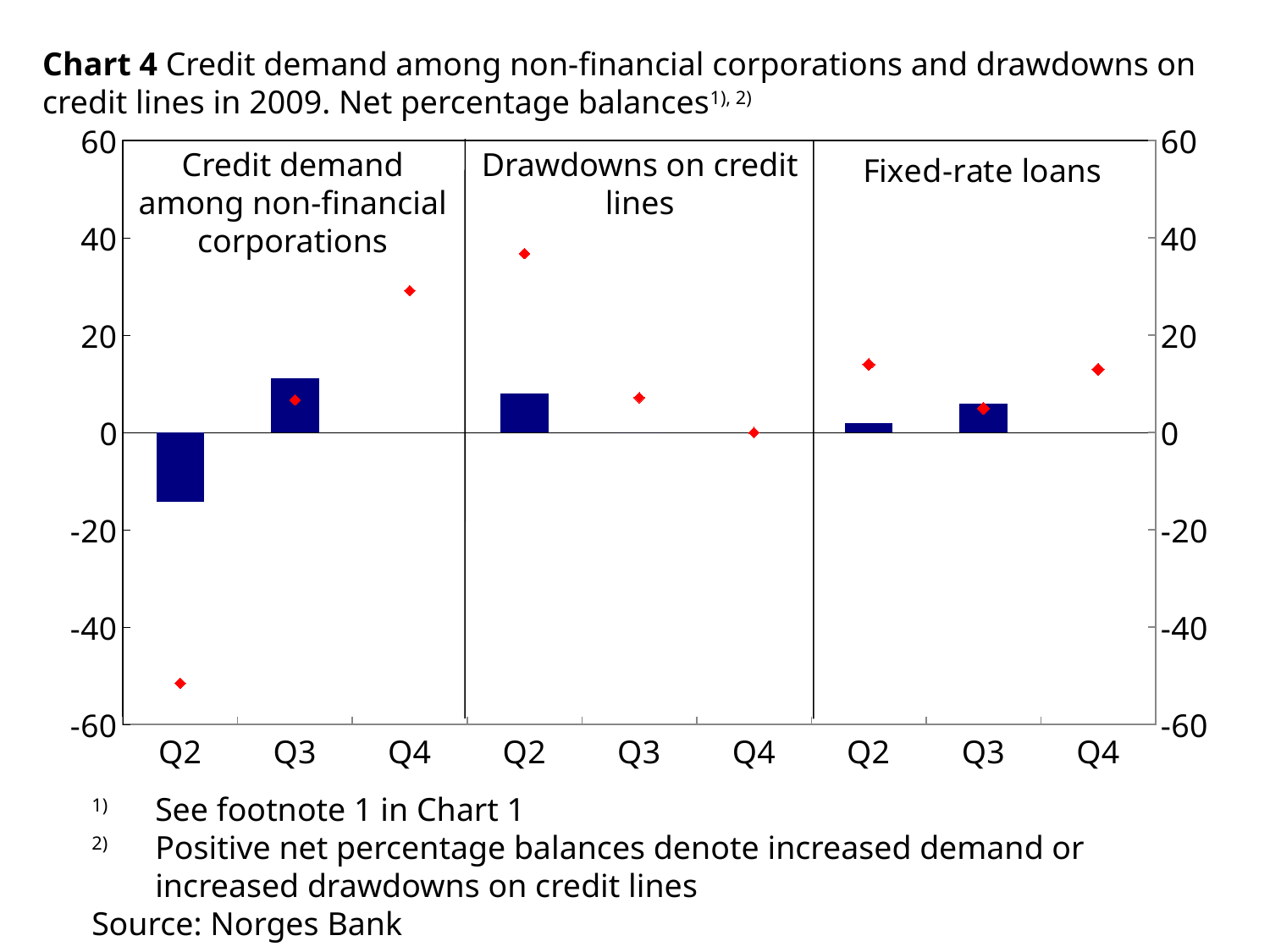
In the 'Fixed-rate loans' panel, which bar is taller, Q2 or Q3? Q3 In the 'Credit demand among non-financial corporations' panel, is the red marker for Q2 greater or less than -40? less How many quarters are shown in each panel of the chart? 3 In the 'Credit demand among non-financial corporations' panel, is the red marker for Q4 greater or less than 20? greater In the 'Drawdowns on credit lines' panel, do the red markers rise or fall from Q2 to Q4? fall What kind of chart is shown on the slide? combination bar and line chart (bars with red diamond markers) What is the source given for the chart? Norges Bank In the 'Credit demand among non-financial corporations' panel, is the bar for Q2 greater or less than -20? greater How many panels does the chart have? 3 In the 'Drawdowns on credit lines' panel, which quarter has the highest red marker? Q2 In the 'Credit demand among non-financial corporations' panel, which quarter has the lowest red marker? Q2